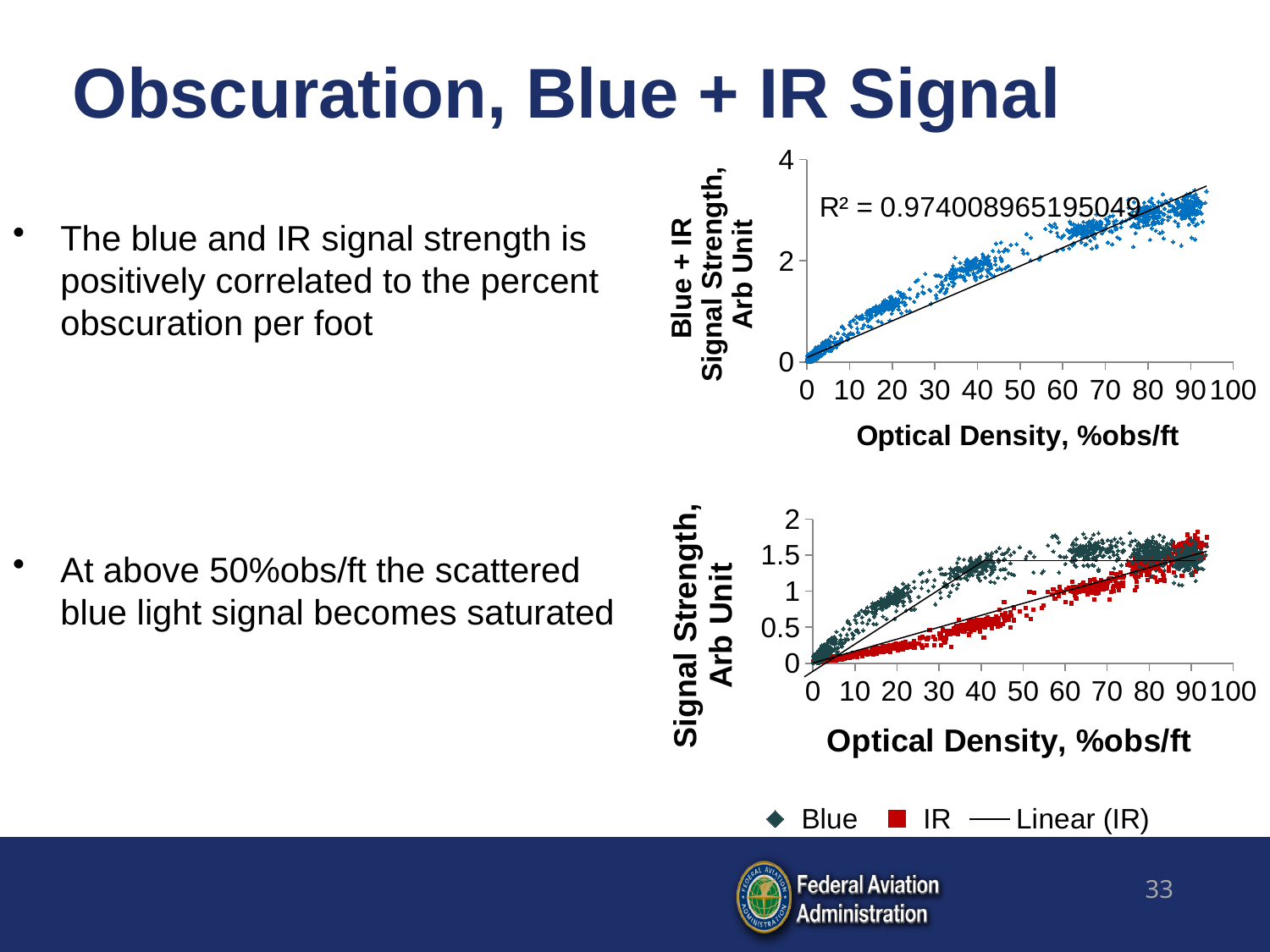
How many entries does the legend of the bottom chart list? 3 In the top chart, is the Blue + IR signal strength at an optical density of 90 %obs/ft greater or less than 2? greater In the bottom chart, at an optical density of 20 %obs/ft, which series has the larger signal strength, Blue or IR? Blue In the bottom chart, is the Blue signal strength at an optical density of 60 %obs/ft greater or less than 1? greater What kind of chart is the top chart on the slide? scatter chart What is the x-axis label of the top chart? Optical Density, %obs/ft What are the legend entries of the bottom chart? Blue, IR, Linear (IR) In the bottom chart, does the IR signal strength rise or fall as optical density increases? rise In the top chart, does the Blue + IR signal strength rise or fall as optical density increases? rise In the bottom chart, is the IR signal strength at an optical density of 20 %obs/ft greater or less than 0.5? less What R² value is printed on the top chart? R² = 0.974008965195049 What is the highest tick value on the y-axis of the top chart? 4